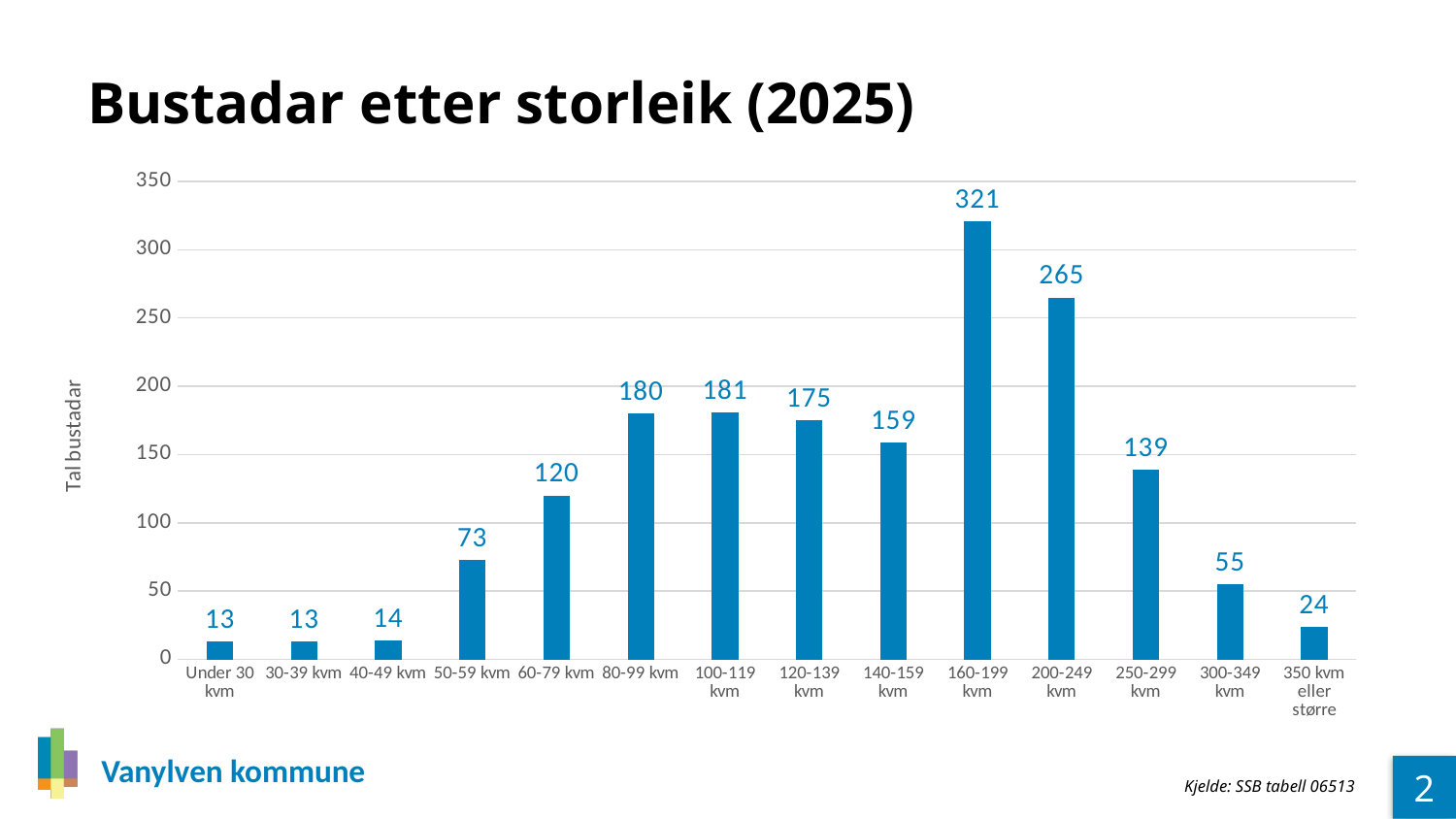
What is the difference between the values for 160-199 kvm and 200-249 kvm? 56 What is the difference between the values for 80-99 kvm and 60-79 kvm? 60 What kind of chart is shown on the slide? Bar chart Is the value for 250-299 kvm greater or less than 150? less Which category has the highest value? 160-199 kvm How many dwellings are shown for the 50-59 kvm category? 73 What is the title of the chart? Bustadar etter storleik (2025) How many size categories are shown on the x axis? 14 What is the label on the vertical axis? Tal bustadar What is the value for the 160-199 kvm category? 321 Which is larger, the value for 120-139 kvm or the value for 140-159 kvm? 120-139 kvm What is the value for the '350 kvm eller større' category? 24